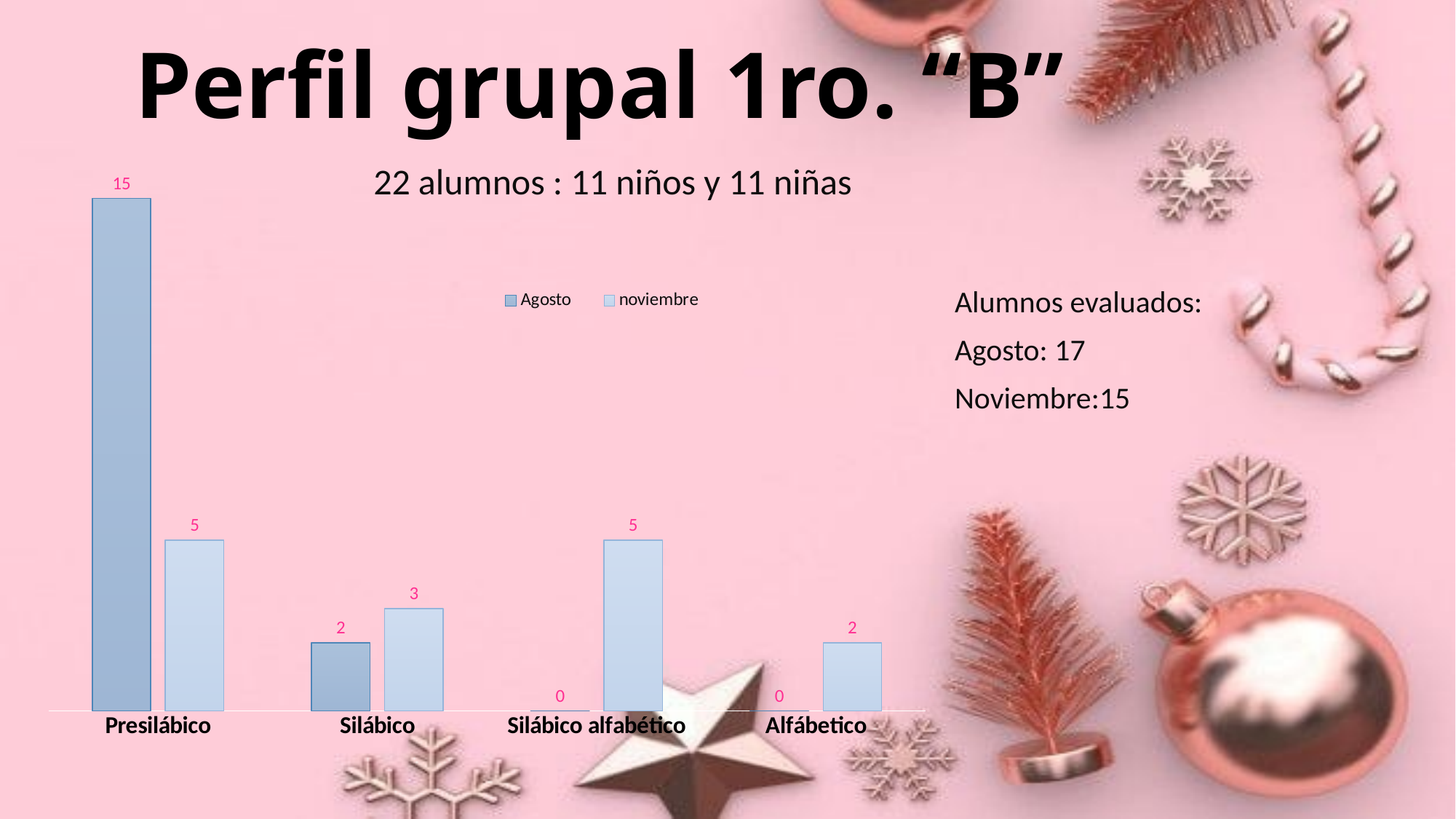
What is the Agosto value for Presilábico? 15 What is the Agosto value for Silábico alfabético? 0 Which is larger for Silábico alfabético: the Agosto value or the noviembre value? noviembre What is the noviembre value for Alfábetico? 2 Which category has the highest Agosto value? Presilábico Which category has the lowest noviembre value? Alfábetico What kind of chart is shown on the slide? bar chart What is the noviembre value for Presilábico? 5 What is the difference between the Agosto and noviembre values for Presilábico? 10 What is the noviembre value for Silábico? 3 How many series does the legend list? 2 How many categories are shown on the x axis? 4